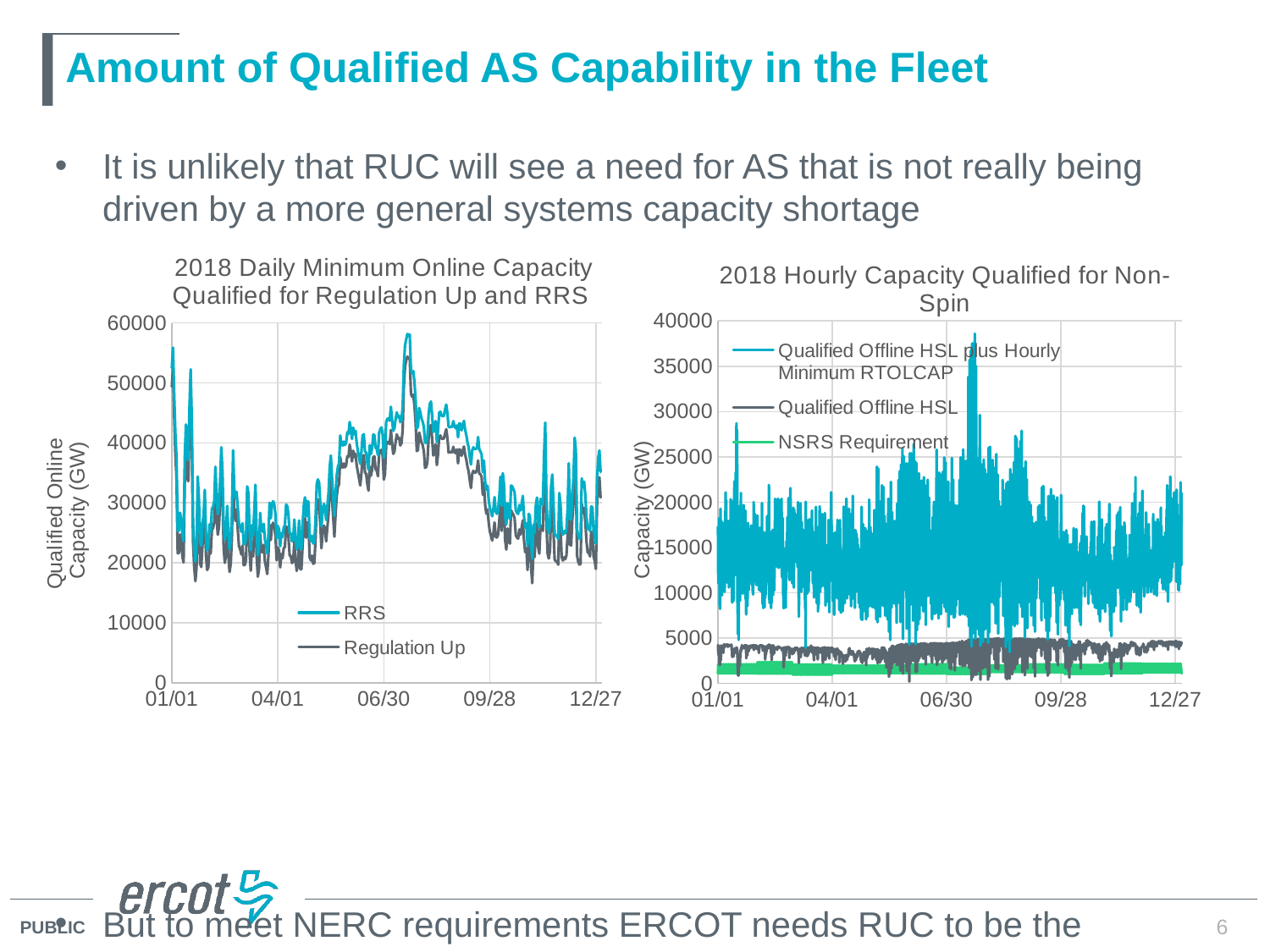
In the right chart, is the highest peak of the 'Qualified Offline HSL plus Hourly Minimum RTOLCAP' series greater or less than 35000? greater How many series does the legend of the left chart list? 2 In the left chart, is the Regulation Up value around 04/01 greater or less than 30000? less In the right chart, is the Qualified Offline HSL series greater or less than 10000 throughout the year? less What is the y-axis label of the right chart? Capacity (GW) In the left chart, which series is generally higher across the year, RRS or Regulation Up? RRS In the right chart, which series has the lowest values throughout the year? NSRS Requirement What is the title of the right chart? 2018 Hourly Capacity Qualified for Non-Spin What kind of chart is the left chart, '2018 Daily Minimum Online Capacity Qualified for Regulation Up and RRS'? Line chart How many series does the legend of the right chart, '2018 Hourly Capacity Qualified for Non-Spin', list? 3